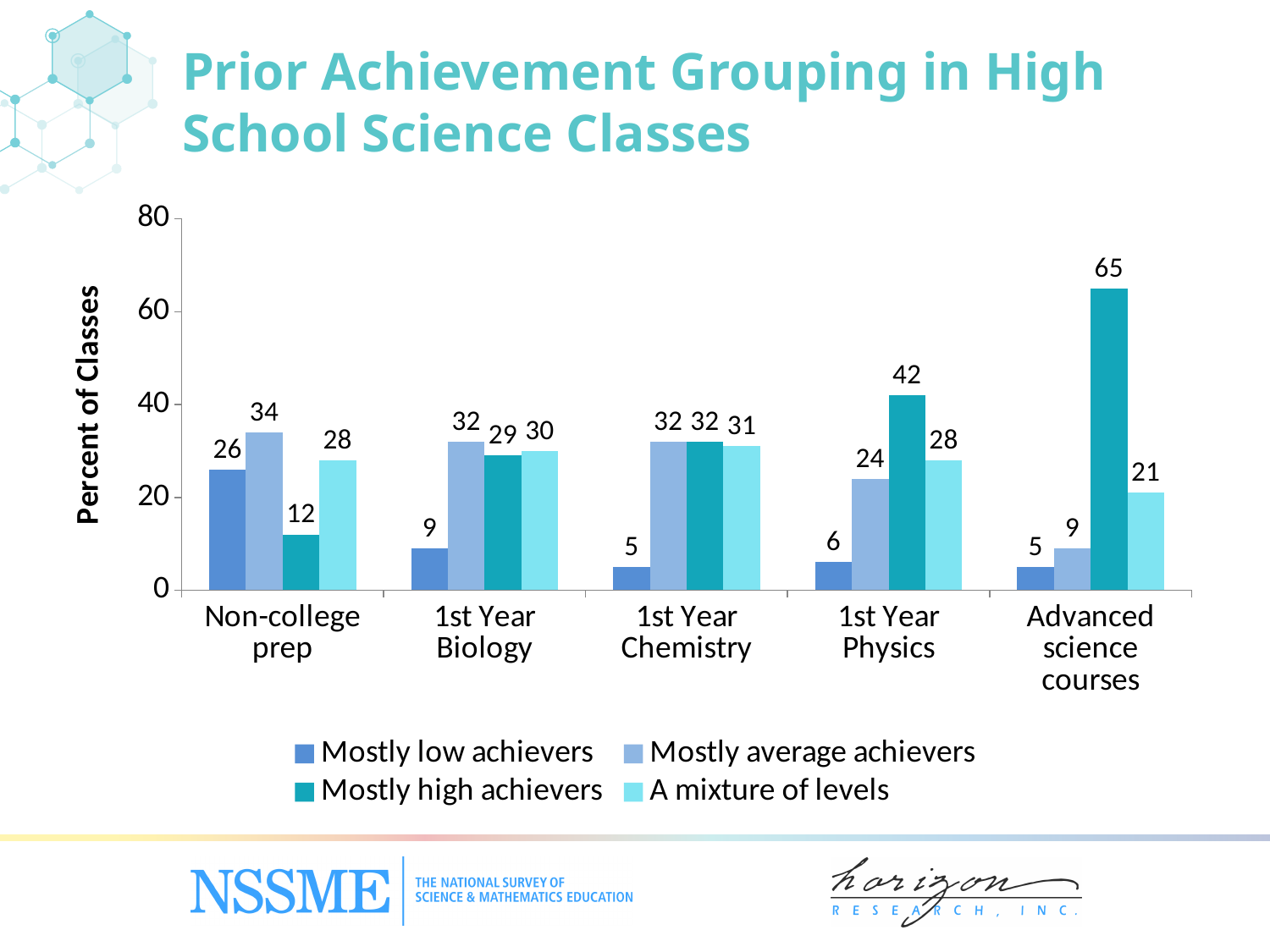
What percent of 1st Year Physics classes are a mixture of levels? 28 What is the difference between the mostly high achievers values for Advanced science courses and 1st Year Physics? 23 Which is larger for Non-college prep: mostly low achievers or mostly high achievers? Mostly low achievers What is the label of the y axis? Percent of Classes How many series does the legend list? 4 What percent of Advanced science courses are grouped as mostly high achievers? 65 What percent of Non-college prep classes are grouped as mostly average achievers? 34 Which course category has the lowest value for mostly low achievers? 1st Year Chemistry and Advanced science courses (both 5) How many course categories are shown on the x axis? 5 Which course category has the highest value for mostly high achievers? Advanced science courses What kind of chart is shown on the slide? Bar chart How do the mostly high achievers values change from Non-college prep to Advanced science courses? They rise